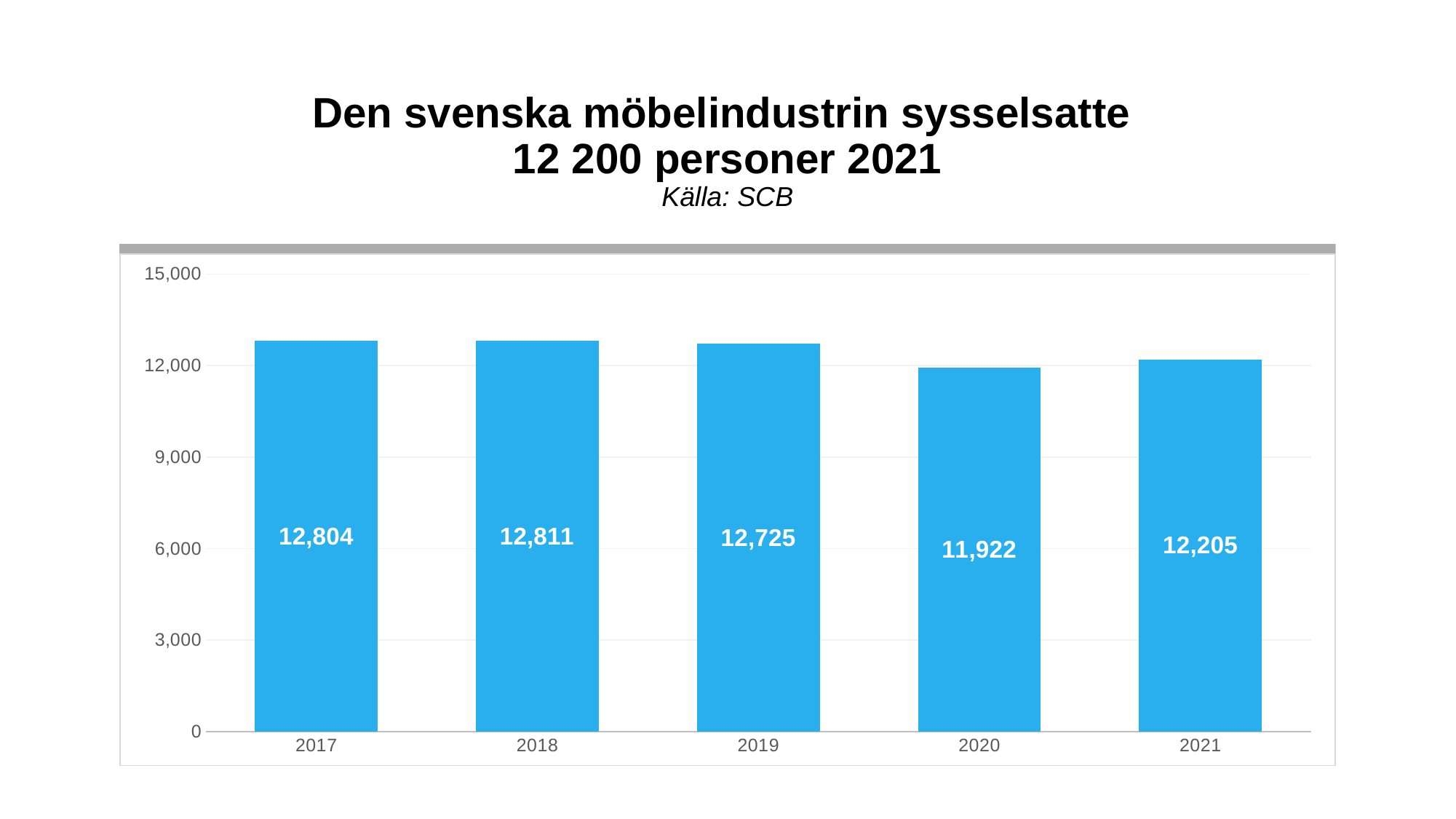
What is the value for 2021? 12,205 Which is larger, the value for 2019 or the value for 2021? 2019 What source is cited below the chart title? SCB How many years are shown on the x axis? 5 What is the value for 2017? 12,804 Which year has the lowest value? 2020 Do the values rise or fall from 2019 to 2020? fall Is the value for 2020 greater or less than 12,000? less What is the value for 2020? 11,922 What is the difference between the values for 2021 and 2020? 283 What kind of chart is shown on the slide? bar chart What is the difference between the values for 2019 and 2020? 803